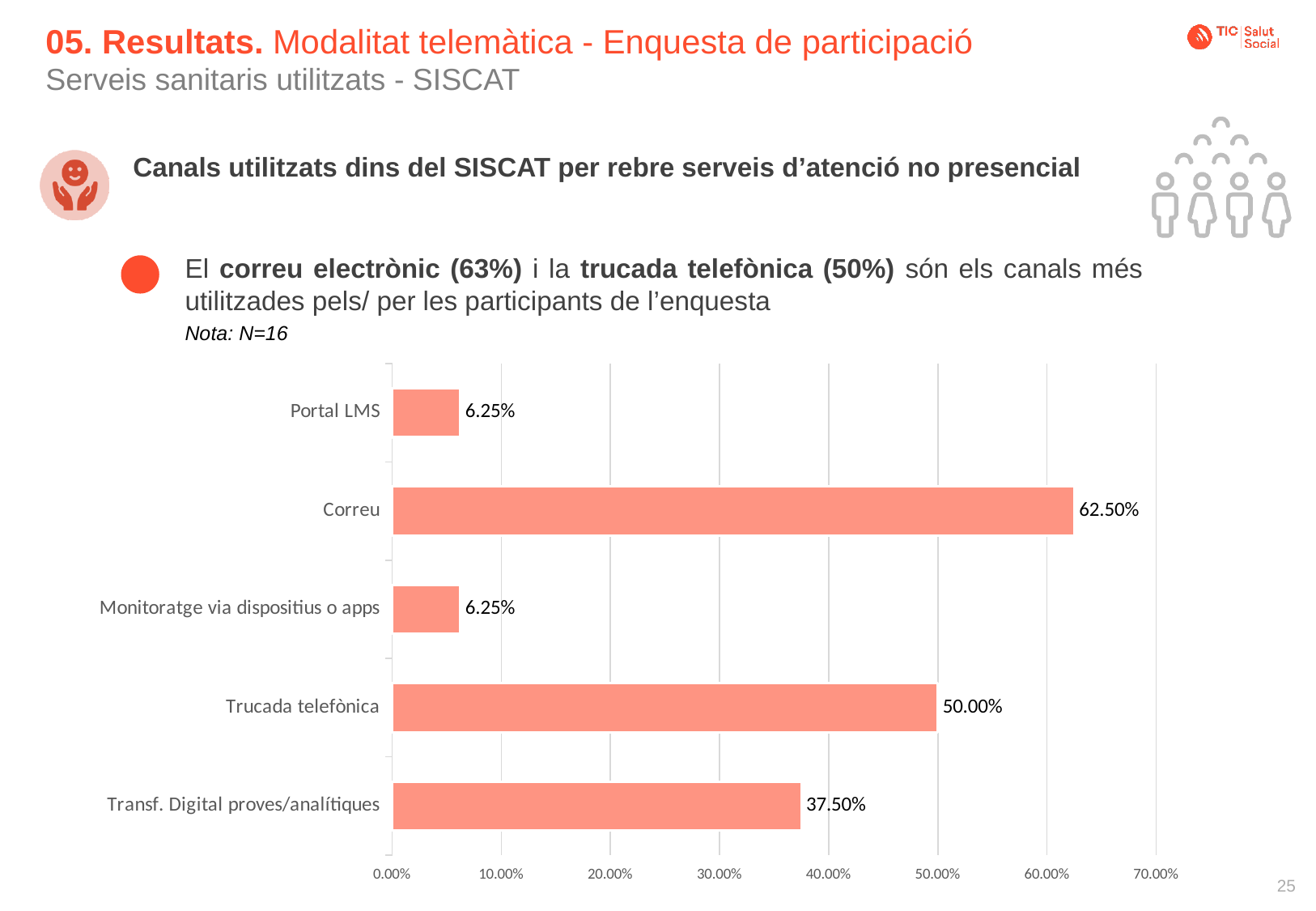
What is the value for Trucada telefònica? 50.00% What is the value for Correu? 62.50% Which category has the highest value? Correu What is the difference between the values for Correu and Trucada telefònica? 12.50% What is the value for Portal LMS? 6.25% Is the value for Correu greater or less than 60.00%? greater Which is larger, the value for Transf. Digital proves/analítiques or the value for Monitoratge via dispositius o apps? Transf. Digital proves/analítiques What is the value for Transf. Digital proves/analítiques? 37.50% How many categories are shown in the chart? 5 What kind of chart is shown on the slide? Bar chart What is the sample size noted above the chart? N=16 What is the difference between the values for Trucada telefònica and Transf. Digital proves/analítiques? 12.50%